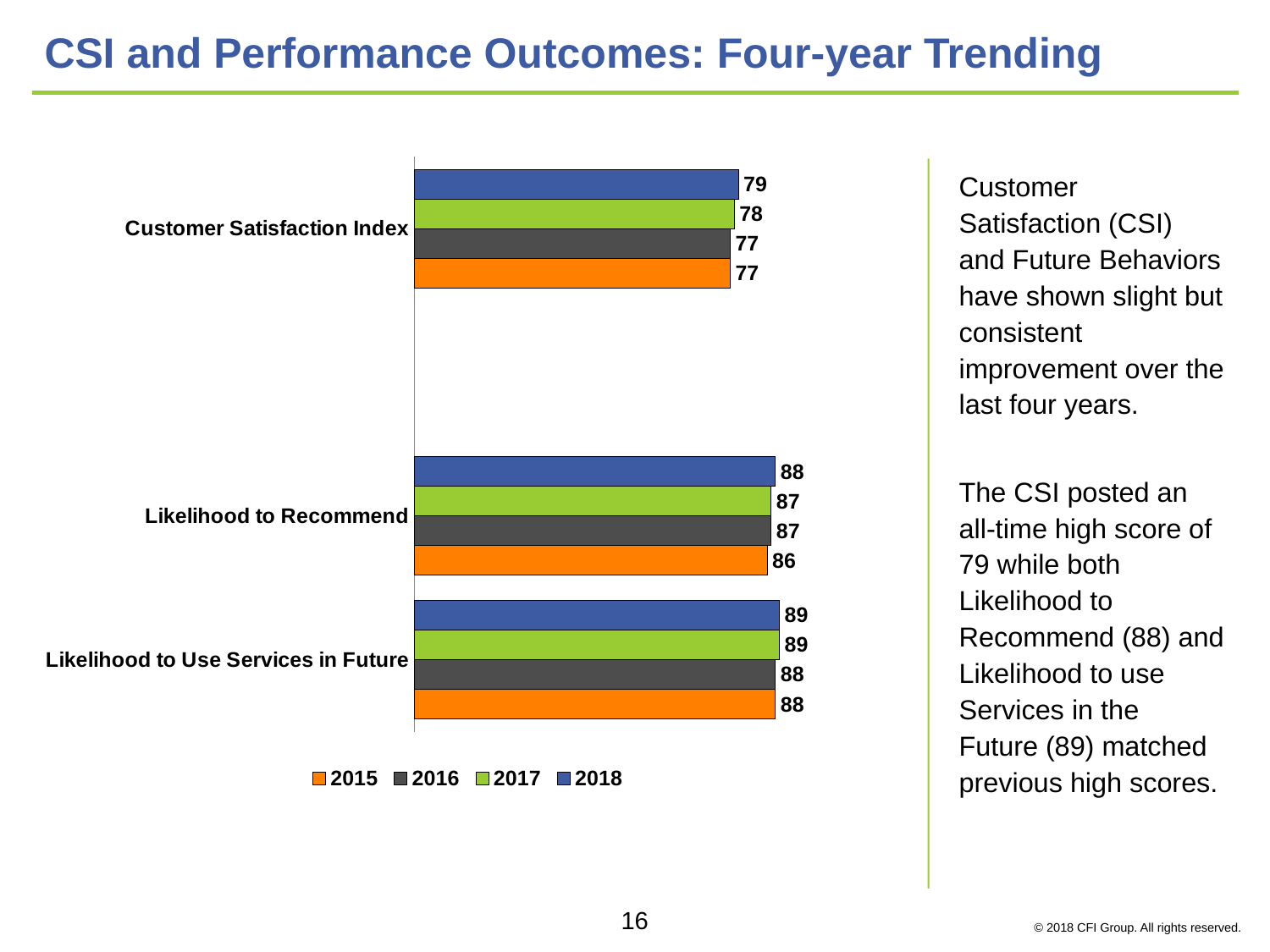
How many categories are shown on the chart? 3 What is the difference between the 2018 and 2015 values for the Customer Satisfaction Index? 2 Which colour represents 2015 in the legend? Orange What kind of chart is shown on the slide? Bar chart Which category has the highest value for 2018? Likelihood to Use Services in Future What is the Customer Satisfaction Index value for 2018? 79 What is the Likelihood to Use Services in Future value for 2017? 89 What is the Likelihood to Recommend value for 2015? 86 What is the Customer Satisfaction Index value for 2016? 77 How many series does the legend list? 4 Which category has the lowest value for 2015? Customer Satisfaction Index Which is larger: the 2018 value for Likelihood to Recommend or the 2018 value for Likelihood to Use Services in Future? Likelihood to Use Services in Future